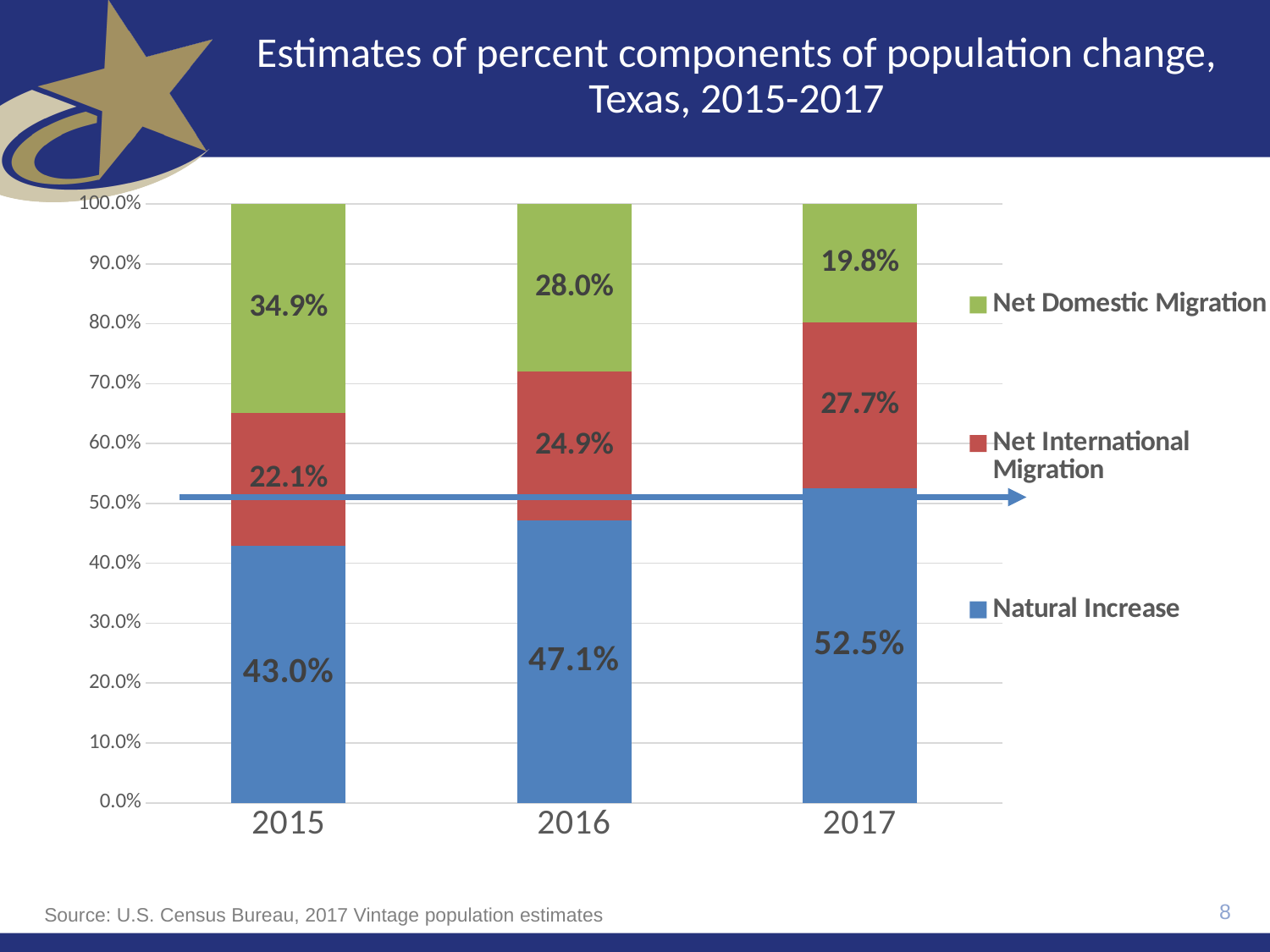
What is the Net Domestic Migration value for 2015? 34.9% How many years are shown on the x axis? 3 What is the total of the stacked bar for 2016? 100.0% What is the Natural Increase value for 2017? 52.5% What is the difference between the Natural Increase values for 2017 and 2015? 9.5% How many series does the legend list? 3 Which year has the highest Natural Increase value? 2017 Does the Net Domestic Migration value rise or fall from 2015 to 2017? Fall What is the Net International Migration value for 2016? 24.9% What kind of chart is shown on the slide? Stacked bar chart Which year has the lowest Net Domestic Migration value? 2017 Which is larger in 2016: Net Domestic Migration or Net International Migration? Net Domestic Migration